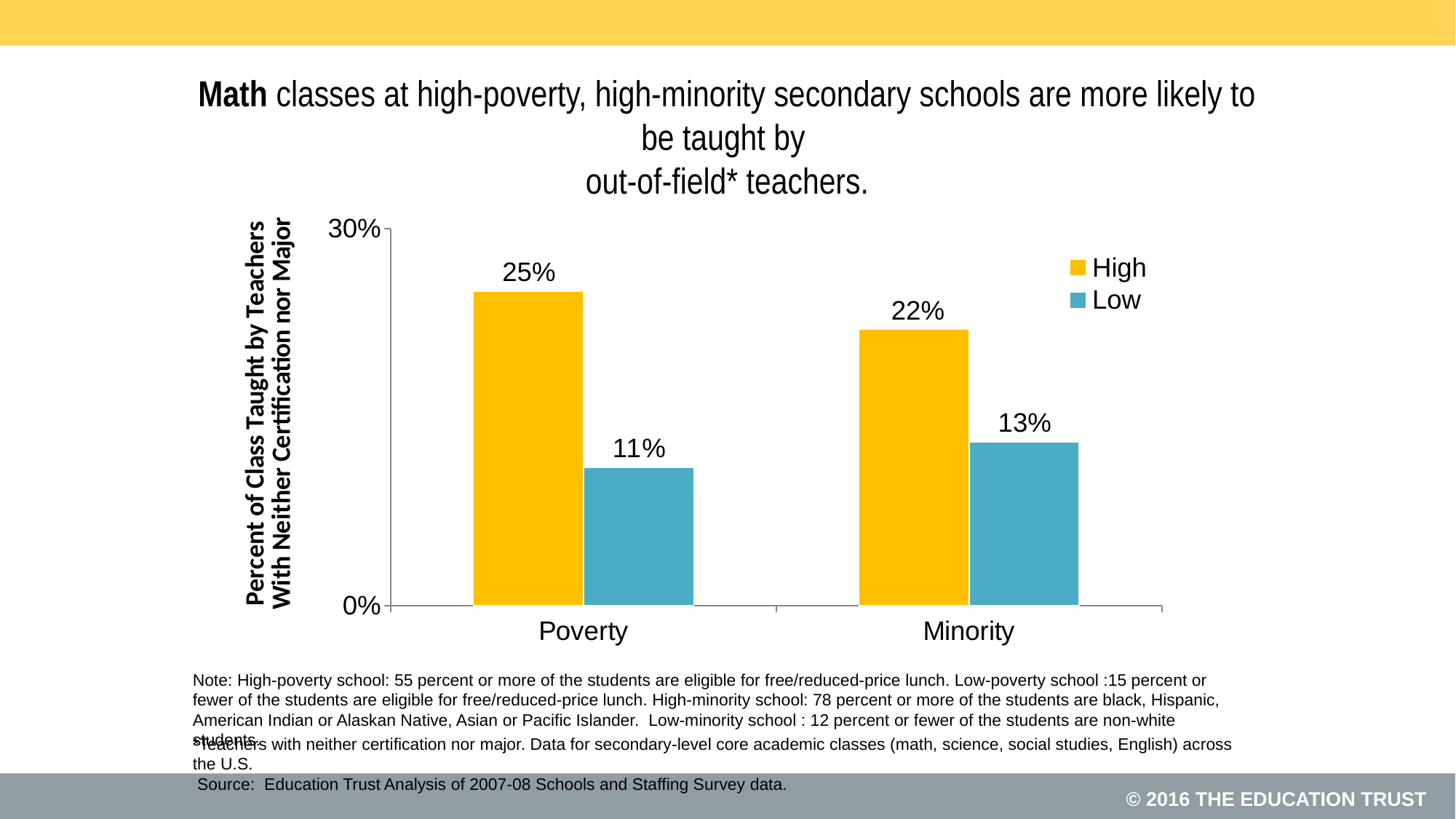
What is the value for Low in the Poverty category? 11% Which bar has the lowest value on the chart? Low, Poverty What is the value for High in the Poverty category? 25% What is the difference between the High and Low values in the Minority category? 9% What is the difference between the High and Low values in the Poverty category? 14% What is the value for High in the Minority category? 22% How many series does the legend list? 2 What kind of chart is shown on the slide? Bar chart Which is larger, the High value for Poverty or the High value for Minority? High value for Poverty How many categories are shown on the x axis? 2 Which bar has the highest value on the chart? High, Poverty What is the value for Low in the Minority category? 13%